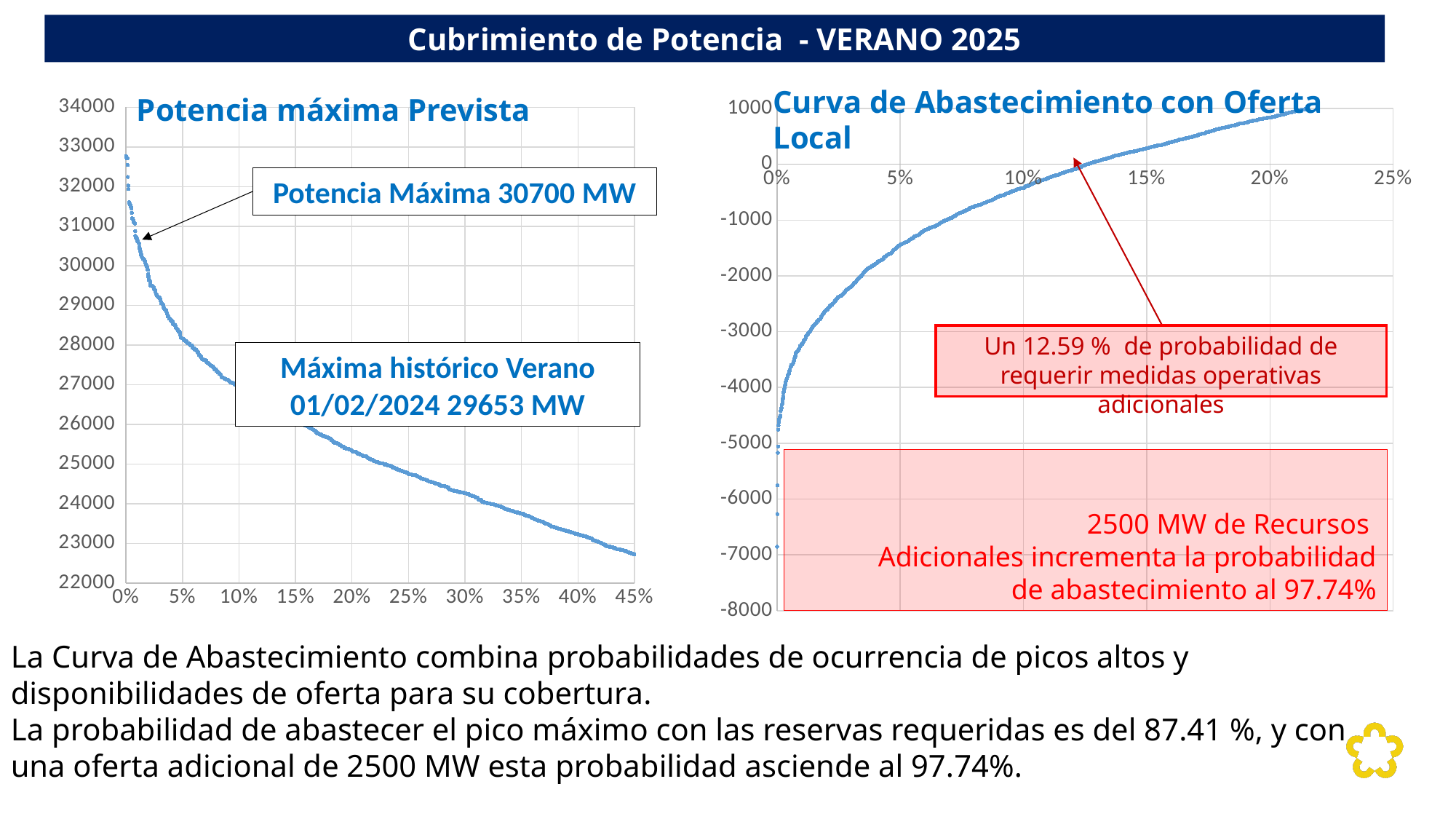
In the 'Potencia máxima Prevista' chart, do the values rise or fall as the x axis increases from 0% to 45%? fall What kind of chart is the 'Potencia máxima Prevista' chart on the left? scatter chart In the 'Potencia máxima Prevista' chart, is the value at 45% greater or less than 23000? less In the 'Potencia máxima Prevista' chart, is the value at 20% greater or less than 25000? greater According to the annotation on the 'Potencia máxima Prevista' chart, what is the Potencia Máxima? 30700 MW In the 'Curva de Abastecimiento con Oferta Local' chart, do the values rise or fall as the x axis increases from 0% to 25%? rise In the 'Potencia máxima Prevista' chart, which is larger: the value at 5% or the value at 40%? the value at 5% In the 'Curva de Abastecimiento con Oferta Local' chart, is the value at 5% greater or less than -1000? less According to the annotation on the 'Curva de Abastecimiento con Oferta Local' chart, what is the probability of requiring additional operational measures? 12.59 % What is the highest tick shown on the x axis of the 'Potencia máxima Prevista' chart? 45% According to the annotation on the 'Potencia máxima Prevista' chart, what was the historical summer maximum on 01/02/2024? 29653 MW